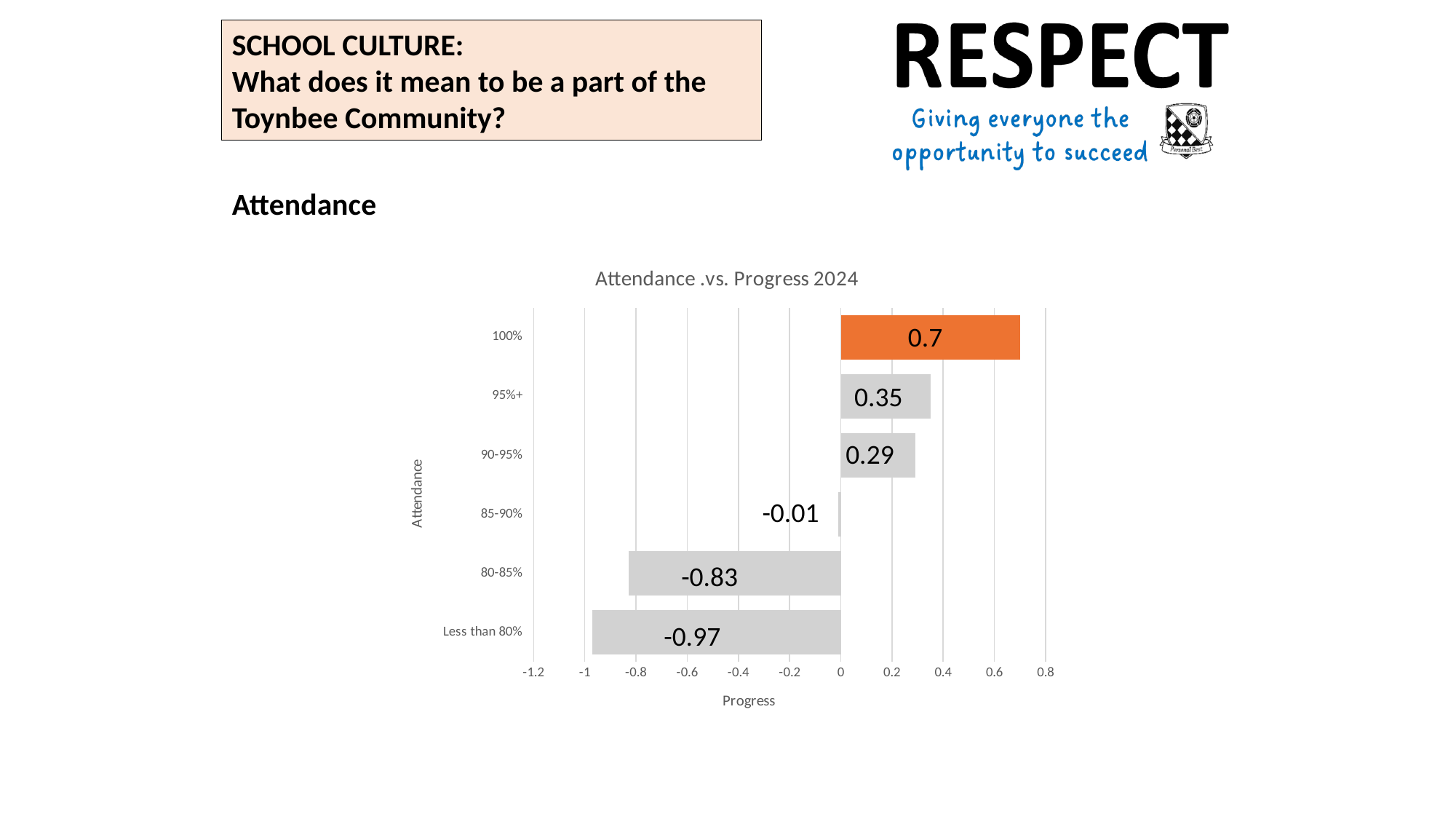
What is the progress value for the 80-85% attendance category? -0.83 What kind of chart is shown on the slide? Bar chart Which bar in the chart is coloured orange? 100% What is the progress value for the 85-90% attendance category? -0.01 What is the difference between the progress values for 95%+ and 90-95%? 0.06 Which attendance category has the highest progress value? 100% What is the title of the chart? Attendance .vs. Progress 2024 Which has a larger progress value, 90-95% or 80-85%? 90-95% What is the difference between the progress values for 100% and 95%+? 0.35 Which attendance category has the lowest progress value? Less than 80% How many attendance categories are shown in the chart? 6 What is the progress value for the 100% attendance category? 0.7